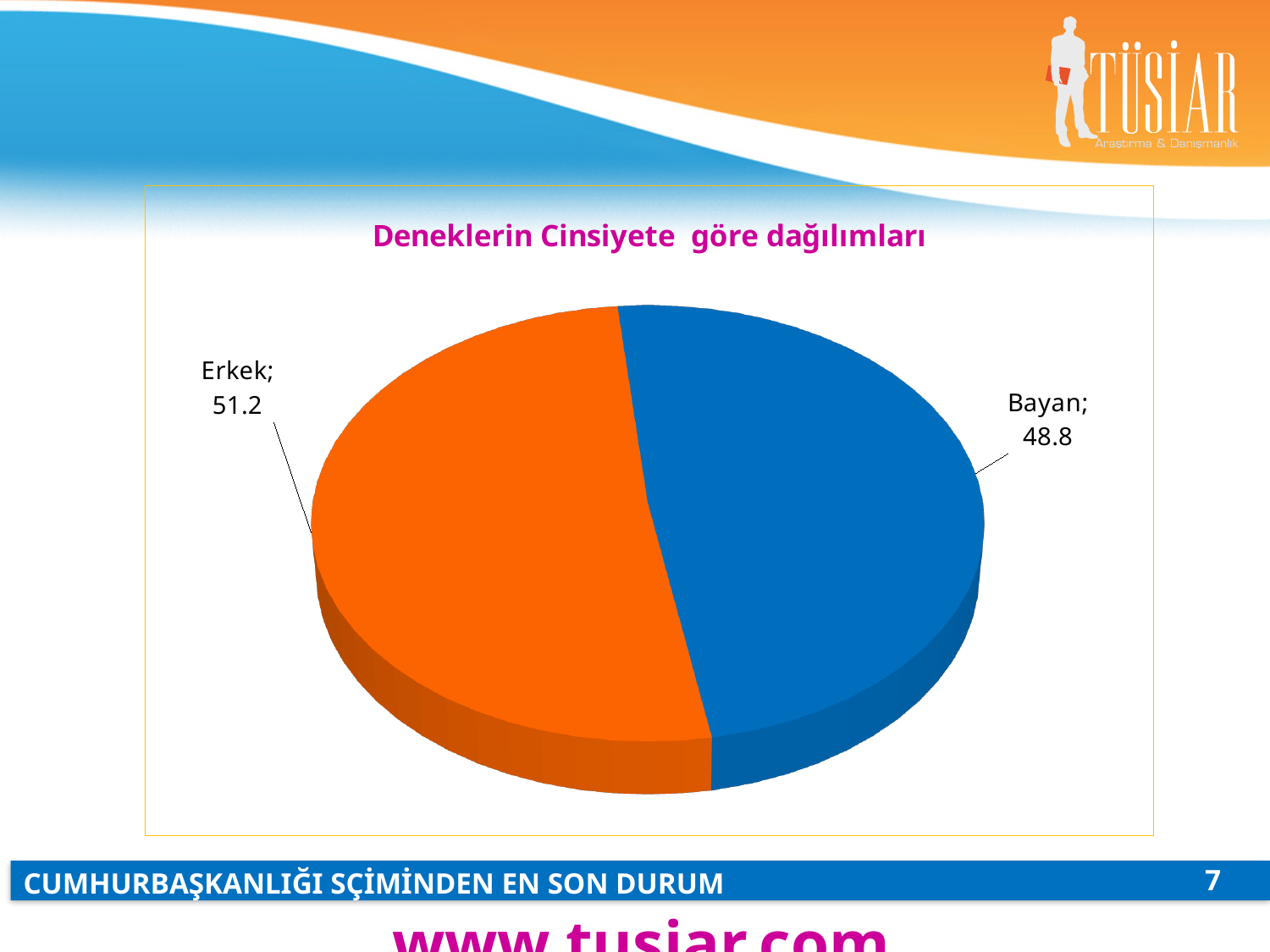
Which category has the largest share of the pie? Erkek Which is larger, the value for Erkek or the value for Bayan? Erkek What is the value for Erkek? 51.2 What is the title of the chart? Deneklerin Cinsiyete göre dağılımları What colour is the Bayan slice? blue What kind of chart is shown on the slide? pie chart What is the difference between the values for Erkek and Bayan? 2.4 What is the value for Bayan? 48.8 How many categories does the pie chart show? 2 Which category has the smallest share of the pie? Bayan